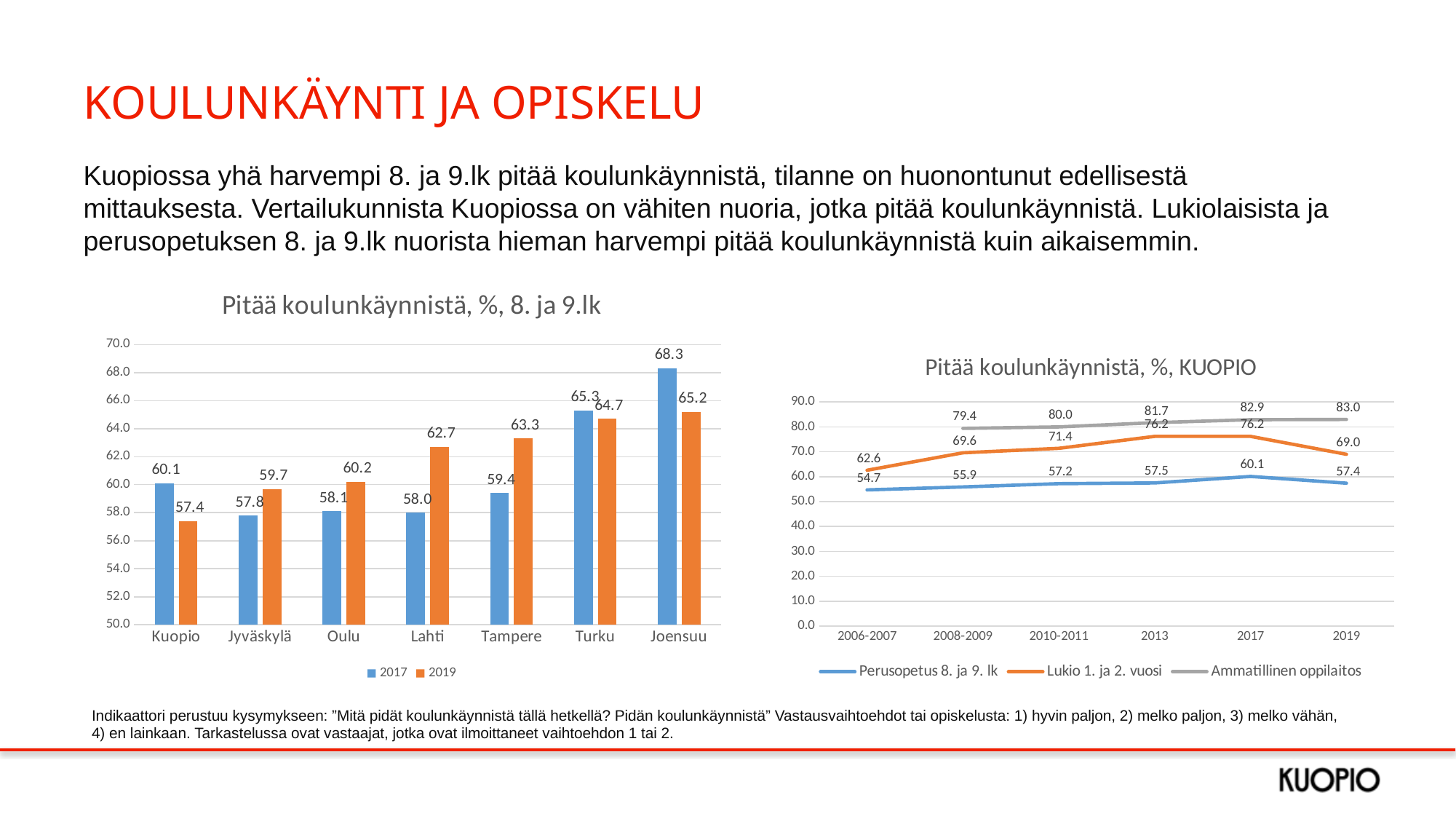
What type of chart is 'Pitää koulunkäynnistä, %, KUOPIO'? line chart What type of chart is 'Pitää koulunkäynnistä, %, 8. ja 9.lk'? bar chart In the chart 'Pitää koulunkäynnistä, %, KUOPIO', what is the difference between Ammatillinen oppilaitos and Perusopetus 8. ja 9. lk in 2019? 25.6 In the chart 'Pitää koulunkäynnistä, %, 8. ja 9.lk', which city has the lowest 2019 value? Kuopio In the chart 'Pitää koulunkäynnistä, %, 8. ja 9.lk', which city has the highest 2017 value? Joensuu In the chart 'Pitää koulunkäynnistä, %, KUOPIO', what is the value for Lukio 1. ja 2. vuosi in 2019? 69.0 In the chart 'Pitää koulunkäynnistä, %, KUOPIO', does the Ammatillinen oppilaitos series rise or fall from 2008-2009 to 2019? rise How many series does the legend of the chart 'Pitää koulunkäynnistä, %, KUOPIO' list? 3 How many cities are shown in the chart 'Pitää koulunkäynnistä, %, 8. ja 9.lk'? 7 In the chart 'Pitää koulunkäynnistä, %, 8. ja 9.lk', is the 2017 value for Turku larger or smaller than its 2019 value? larger In the chart 'Pitää koulunkäynnistä, %, 8. ja 9.lk', what is the 2019 value for Kuopio? 57.4 In the chart 'Pitää koulunkäynnistä, %, 8. ja 9.lk', what is the difference between the 2019 and 2017 values for Lahti? 4.7